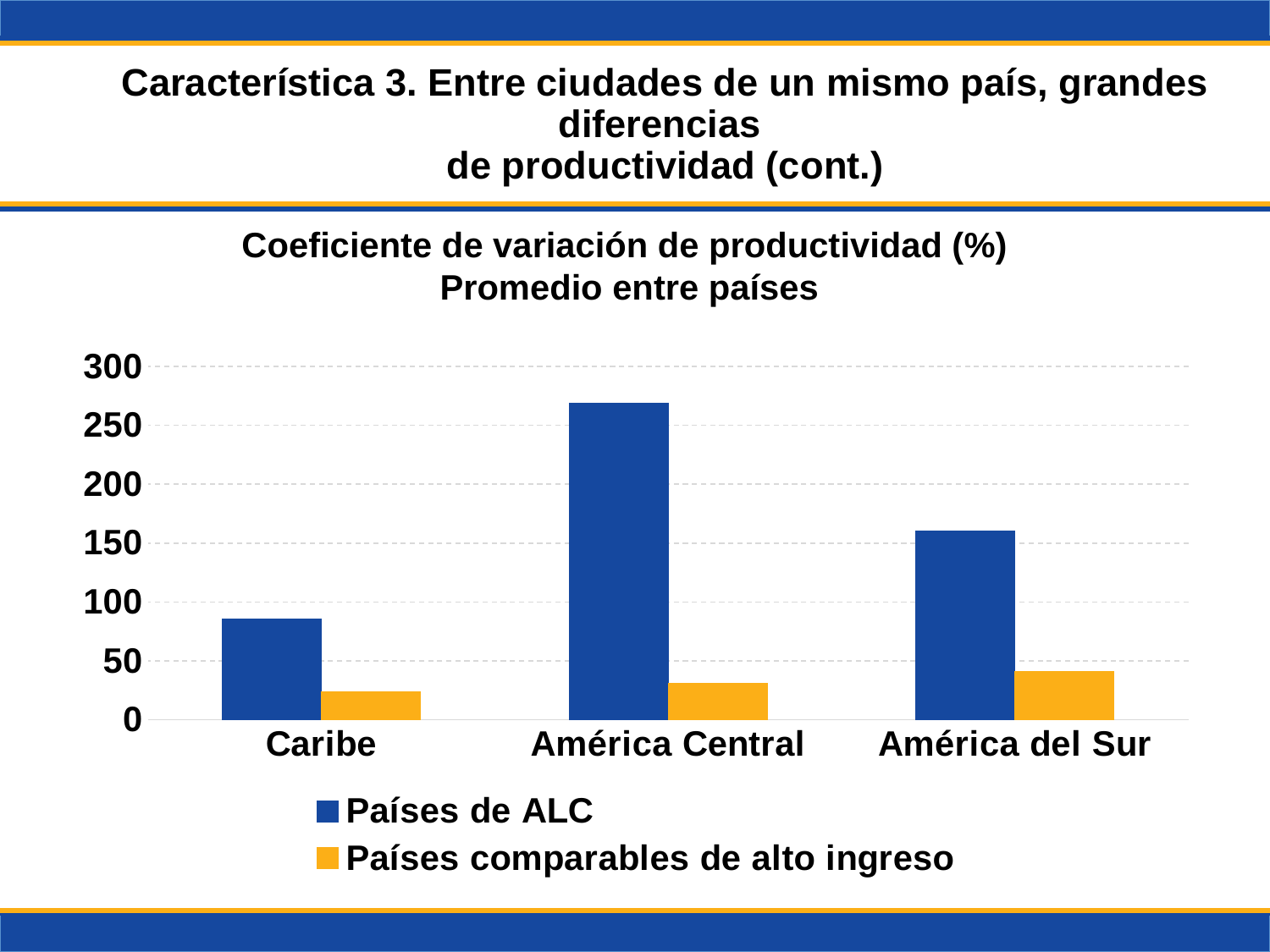
Which category has the lowest value for Países de ALC? Caribe Is the value for Países de ALC in Caribe greater or less than 100? less Is the value for Países comparables de alto ingreso in América Central greater or less than 50? less Which is larger for Países de ALC: Caribe or América del Sur? América del Sur Which category has the highest value for Países de ALC? América Central What kind of chart is shown on the slide? bar chart Is the value for Países de ALC in América del Sur greater or less than 100? greater Which category has the highest value for Países comparables de alto ingreso? América del Sur How many series does the legend list? 2 How many categories are shown on the x axis of the chart? 3 What is the title of the chart? Coeficiente de variación de productividad (%) Promedio entre países